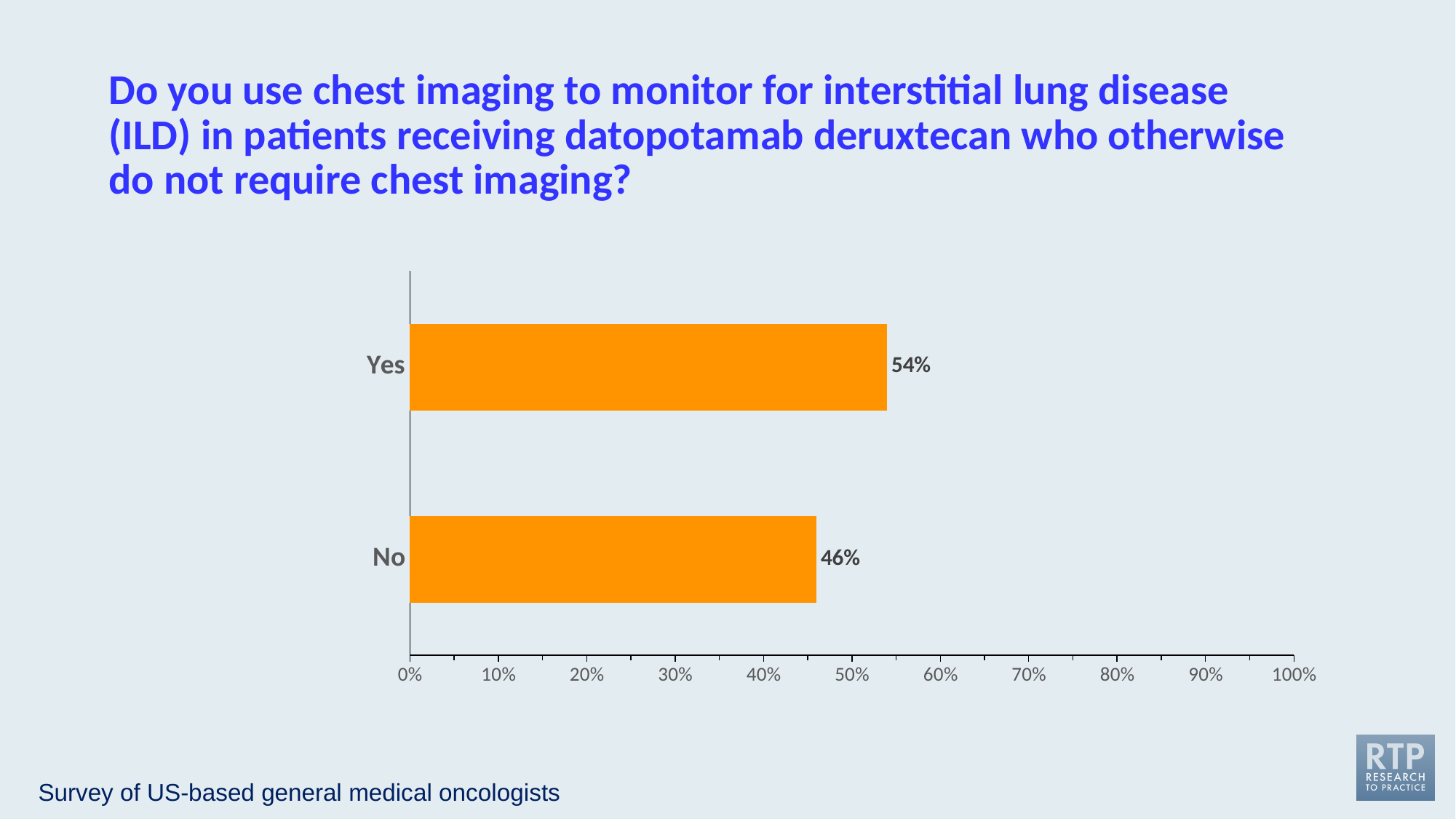
Which response is larger, "Yes" or "No"? Yes What percentage of respondents answered "Yes"? 54% What is the total of the "Yes" and "No" percentages? 100% Which response has the lowest percentage? No Is the value for "Yes" greater or less than 50%? greater What is the difference in percentage points between the "Yes" and "No" responses? 8% Is the value for "No" greater or less than 50%? less What percentage of respondents answered "No"? 46% What type of chart is shown on the slide? Bar chart Which response has the highest percentage? Yes What is the maximum value shown on the horizontal axis? 100% How many response categories are shown in the chart? 2